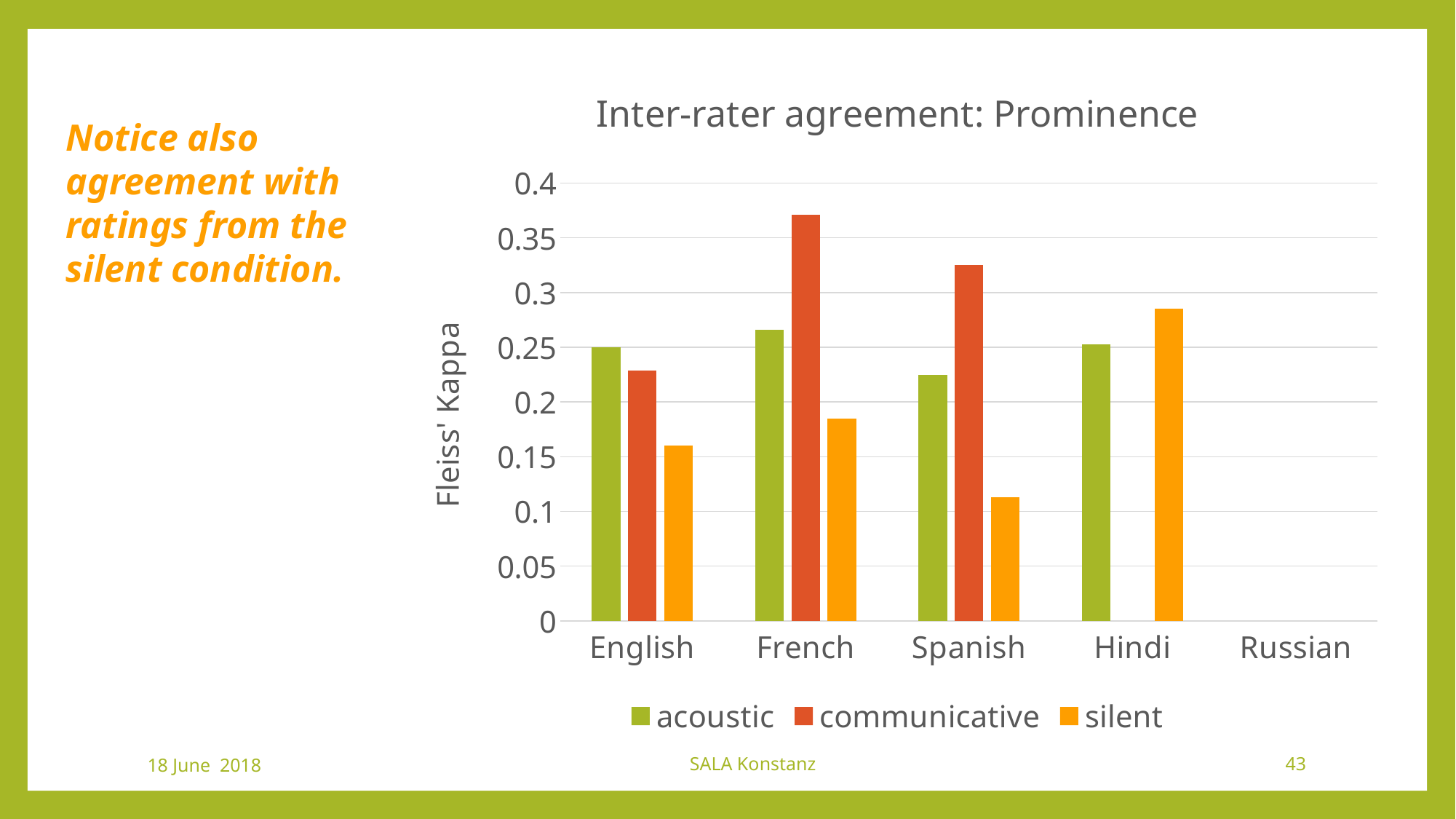
What is the label on the y axis? Fleiss' Kappa How many language categories are shown on the x axis? 5 What kind of chart is shown on the slide? bar chart How many series does the legend list? 3 Which language has the lowest silent bar? Spanish For Hindi, which is larger: the acoustic value or the silent value? silent Which language has the highest communicative bar? French Is the silent value for Hindi greater or less than 0.25? greater Is the silent value for Spanish greater or less than 0.15? less Which language has the highest silent bar? Hindi For English, which is larger: the acoustic value or the silent value? acoustic Is the communicative value for French greater or less than 0.35? greater